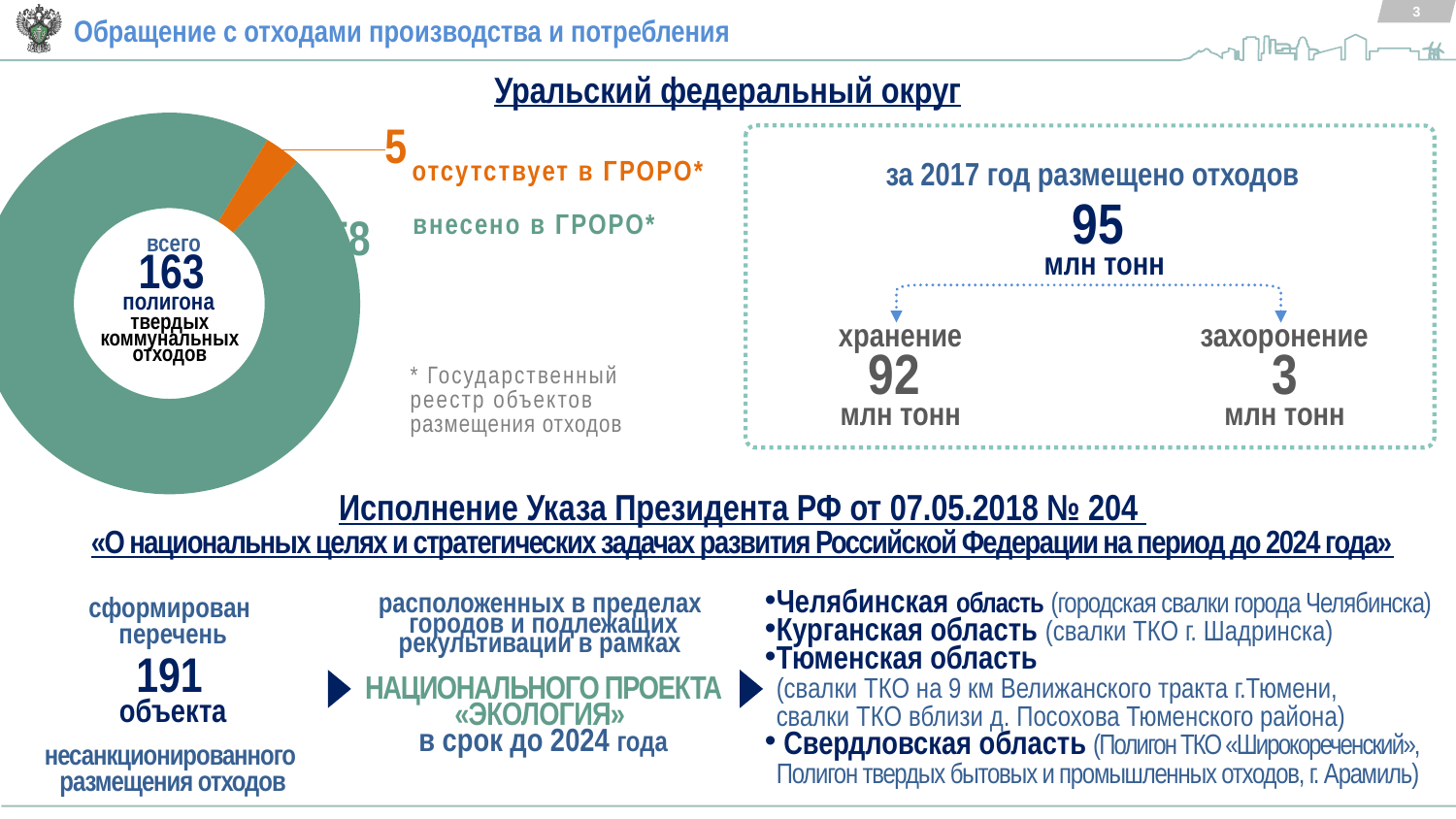
What kind of chart is shown on the left of the slide? doughnut chart How many categories does the pie chart divide the landfills into? 2 Which category takes up the largest part of the pie chart? внесено в ГРОРО What total number of landfills is shown in the centre of the pie chart? 163 What colour is the 'отсутствует в ГРОРО' slice of the pie chart? orange Which category takes up the smallest part of the pie chart? отсутствует в ГРОРО In the pie chart, which is larger: 'внесено в ГРОРО' or 'отсутствует в ГРОРО'? внесено в ГРОРО What does the text in the centre of the pie chart describe the 163 as? полигона твердых коммунальных отходов In the pie chart, how many landfills are marked as 'отсутствует в ГРОРО'? 5